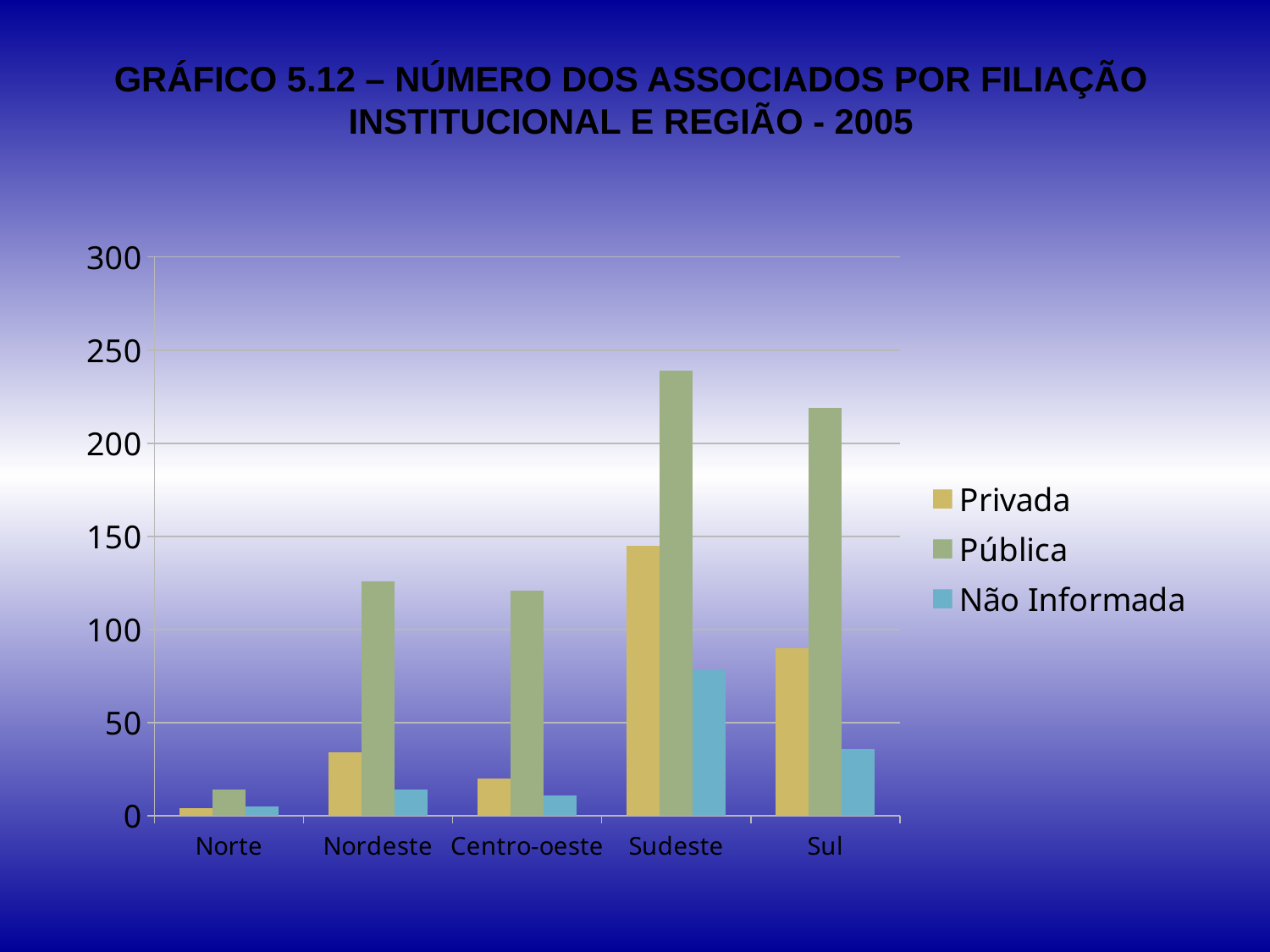
Is the value for Privada in Sul greater or less than 100? less Which series is shown in blue in the legend? Não Informada Is the value for Pública in Sudeste greater or less than 200? greater What kind of chart is shown on the slide? bar chart Which region has the lowest value for Pública? Norte Which region has the highest value for Não Informada? Sudeste Is the value for Pública in Nordeste greater or less than 100? greater Which is larger, the Privada value for Sudeste or the Privada value for Sul? Sudeste How many regions are shown on the x axis? 5 How many series does the legend list? 3 Which region has the highest value for Pública? Sudeste Which region has the highest value for Privada? Sudeste